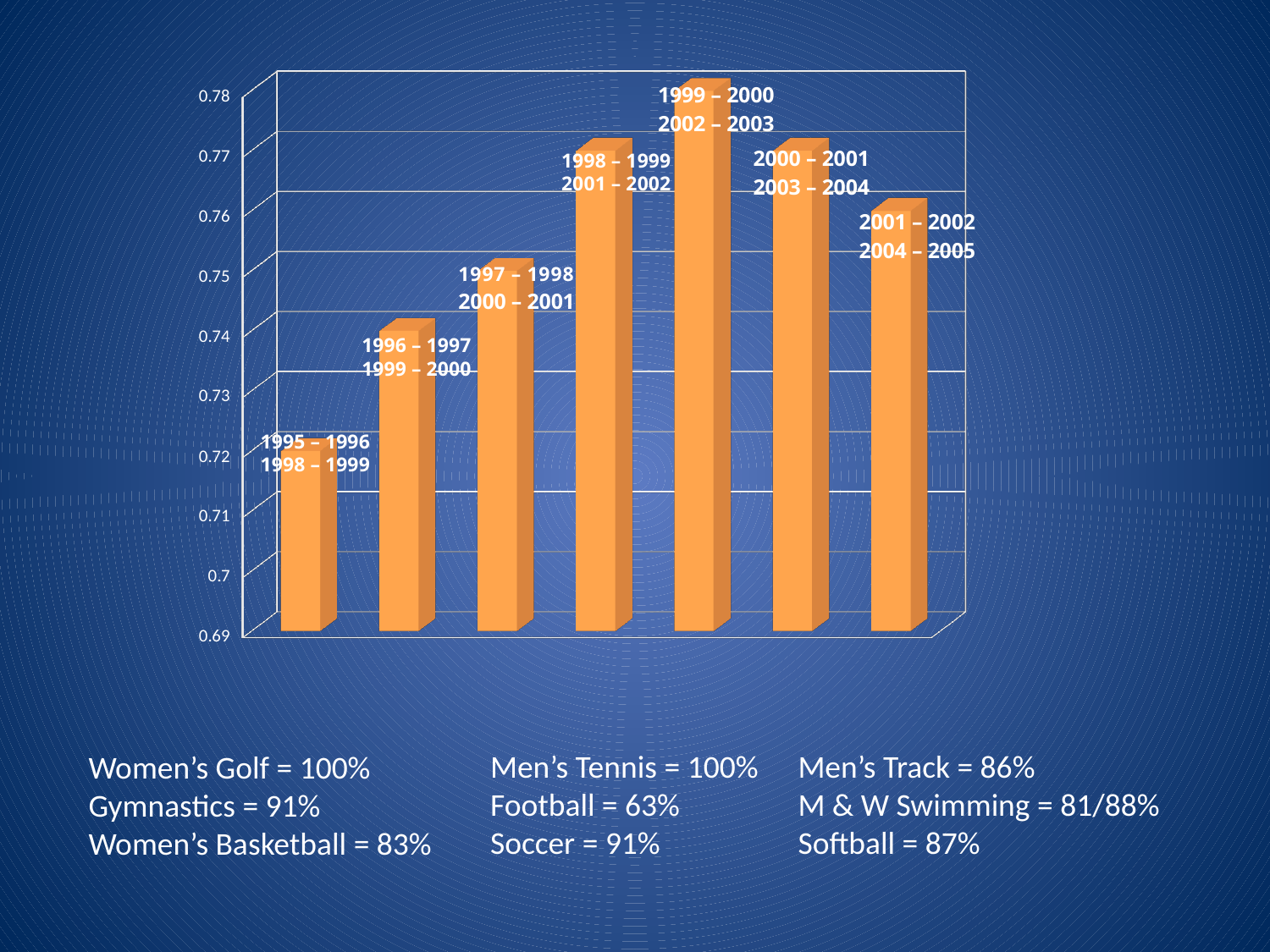
Which is larger, the 1996 – 1997 / 1999 – 2000 bar or the 1997 – 1998 / 2000 – 2001 bar? 1997 – 1998 / 2000 – 2001 What kind of chart is shown on the slide? bar chart Is the value for the 1995 – 1996 / 1998 – 1999 bar greater or less than 0.73? less Do the bar values rise or fall from the first bar to the fifth bar (1999 – 2000 / 2002 – 2003)? rise Which is larger, the 1995 – 1996 / 1998 – 1999 bar or the 2001 – 2002 / 2004 – 2005 bar? 2001 – 2002 / 2004 – 2005 Is the value for the 2001 – 2002 / 2004 – 2005 bar greater or less than 0.75? greater Is the value for the 1999 – 2000 / 2002 – 2003 bar greater or less than 0.77? greater How many bars are plotted in the chart? 7 What colour are the bars in the chart? orange Which bar is the lowest in the chart? 1995 – 1996 / 1998 – 1999 Which bar is the highest in the chart? 1999 – 2000 / 2002 – 2003